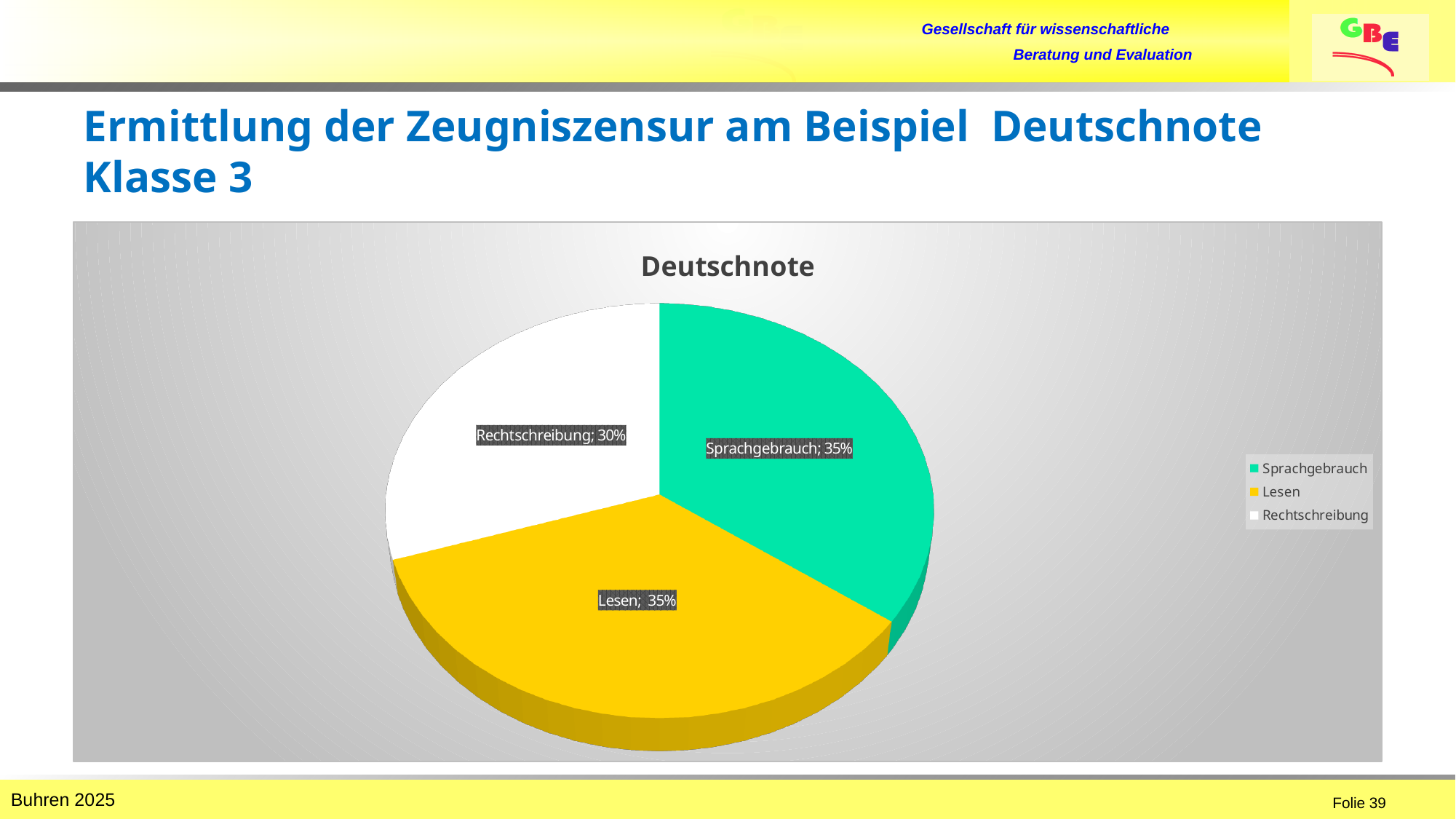
Which category has the smallest slice of the pie? Rechtschreibung How many entries does the legend list? 3 What share of the pie does Sprachgebrauch have? 35% What is the combined share of Sprachgebrauch and Lesen? 70% What is the title of the chart? Deutschnote Which is larger, the share for Lesen or the share for Rechtschreibung? Lesen What is the value shown for Lesen? 35% Which category is shown in yellow? Lesen What is the difference between the shares of Sprachgebrauch and Rechtschreibung? 5% How many slices does the pie chart have? 3 What share of the pie does Rechtschreibung have? 30% What kind of chart is shown on the slide? Pie chart